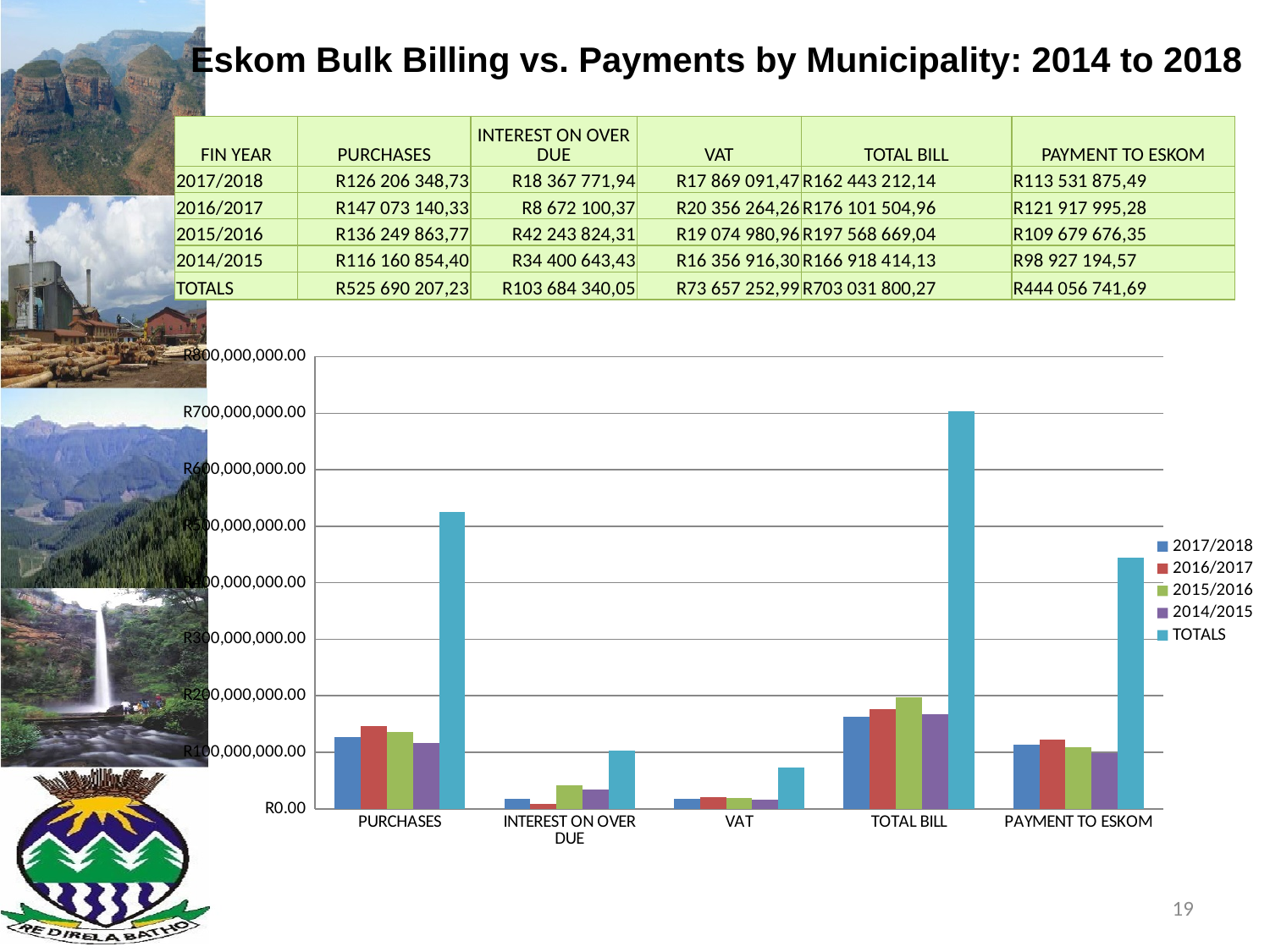
Is the TOTALS value for PAYMENT TO ESKOM greater or less than R400,000,000.00? greater Which financial year has the tallest bar for TOTAL BILL (excluding TOTALS)? 2015/2016 Which category has the tallest bar in the chart? TOTAL BILL What is the PAYMENT TO ESKOM value for 2017/2018? R113 531 875,49 Is the TOTALS value for VAT greater or less than R100,000,000.00? less Is the TOTALS value for PURCHASES greater or less than R500,000,000.00? greater How many series does the chart legend list? 5 What is the difference between the TOTAL BILL for 2015/2016 and for 2014/2015? R30 650 254,91 How many categories are shown along the x axis of the chart? 5 What kind of chart is shown on the slide? bar chart Which financial year has the shortest bar for INTEREST ON OVER DUE? 2016/2017 For PURCHASES, which is larger: the 2016/2017 value or the 2015/2016 value? 2016/2017